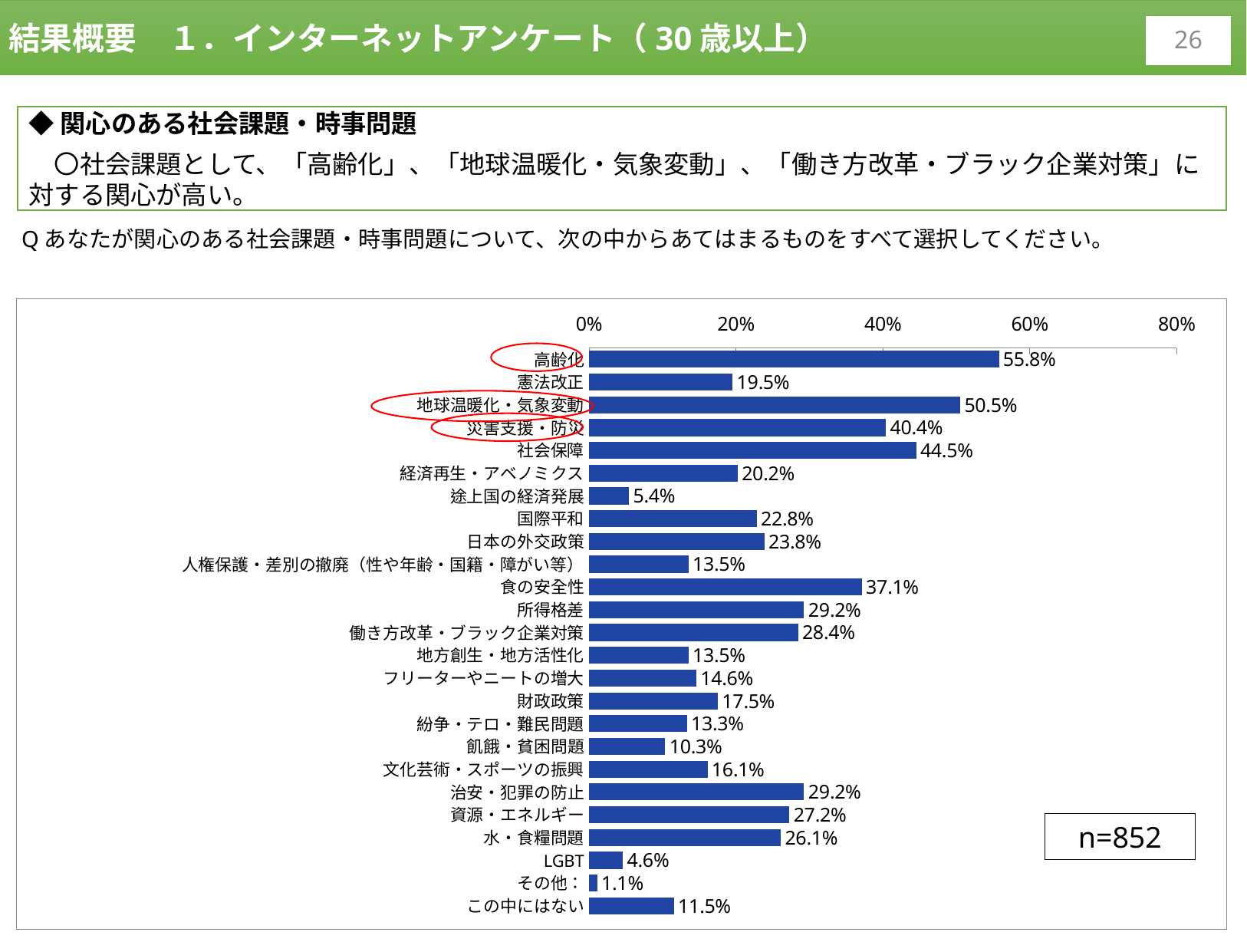
Which category has the highest value? 高齢化 What is the difference between the values for 社会保障 and 災害支援・防災? 4.1 percentage points What is the value for LGBT? 4.6% What is the value for 働き方改革・ブラック企業対策? 28.4% What is the value for 高齢化? 55.8% How many categories are shown in the chart? 25 What is the value for 地球温暖化・気象変動? 50.5% Which category has the lowest value? その他： Is the value for 社会保障 greater or less than 40%? greater Which is larger, the value for 食の安全性 or the value for 所得格差? 食の安全性 What is the difference between the values for 高齢化 and 地球温暖化・気象変動? 5.3 percentage points What kind of chart is shown on the slide? bar chart